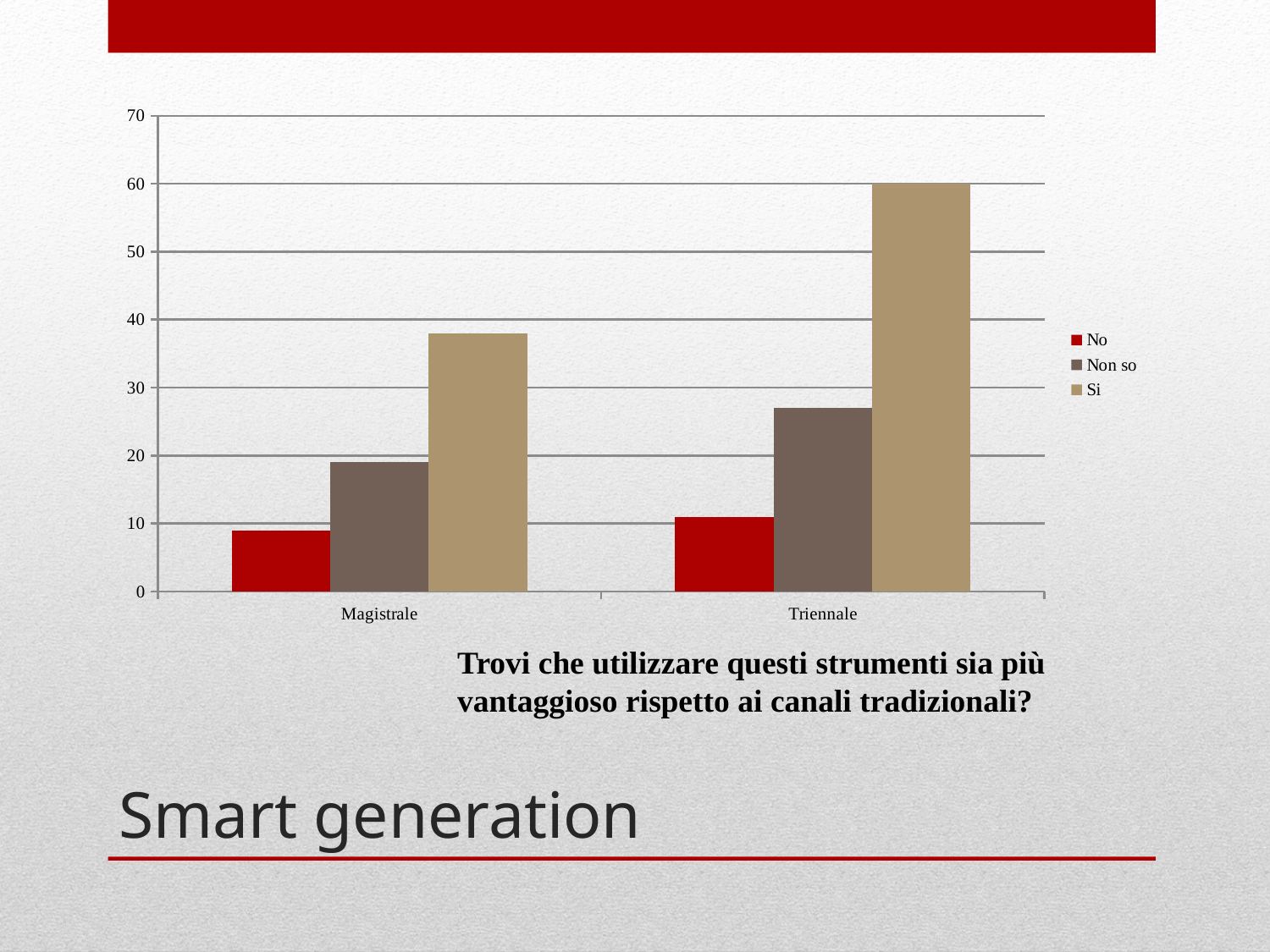
Which series has the highest bar for Triennale? Si Which series has the lowest bar for Magistrale? No Is the value of the Si bar for Magistrale greater or less than 30? greater Is the value of the No bar for Magistrale greater or less than 10? less Which is larger, the Si bar for Magistrale or the Si bar for Triennale? Triennale Which is larger, the Non so bar for Magistrale or the No bar for Triennale? Non so for Magistrale What kind of chart is shown on the slide? bar chart Is the value of the Non so bar for Triennale greater or less than 20? greater How many categories are shown on the x axis? 2 How many series does the legend list? 3 What is the value of the Si bar for Triennale? 60 What are the two categories on the x axis? Magistrale and Triennale